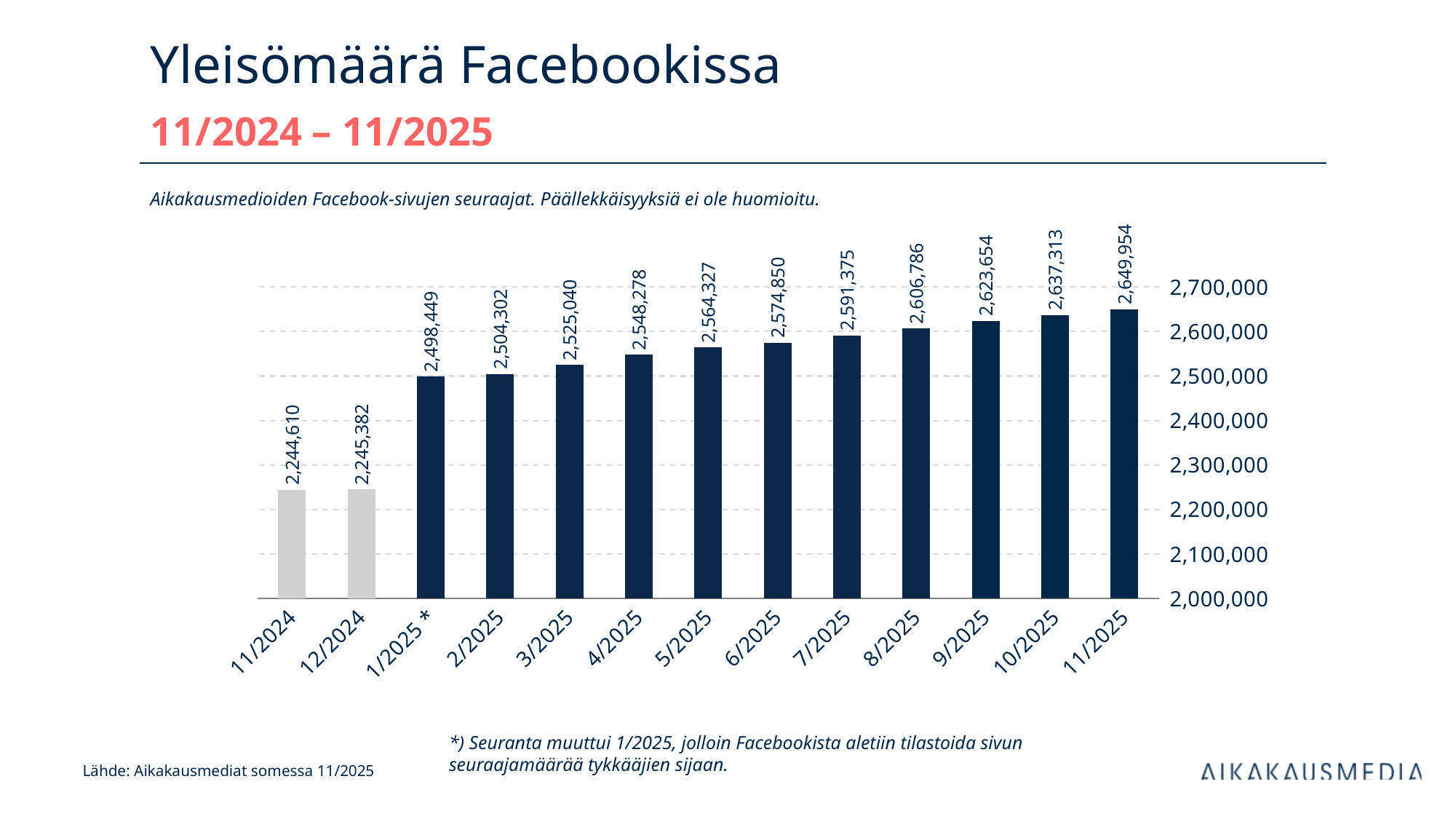
What is the difference between the values for 1/2025 * and 12/2024? 253,067 What kind of chart is shown on the slide? bar chart Which is larger, the value for 3/2025 or the value for 8/2025? 8/2025 What is the value for 1/2025 *? 2,498,449 What is the value for 6/2025? 2,574,850 Which month has the highest value? 11/2025 Do the values rise or fall from 1/2025 * to 11/2025? rise What is the value for 11/2025? 2,649,954 Is the value for 12/2024 greater or less than 2,300,000? less How many months are shown on the x axis? 13 Which month has the lowest value? 11/2024 What is the difference between the values for 11/2025 and 11/2024? 405,344